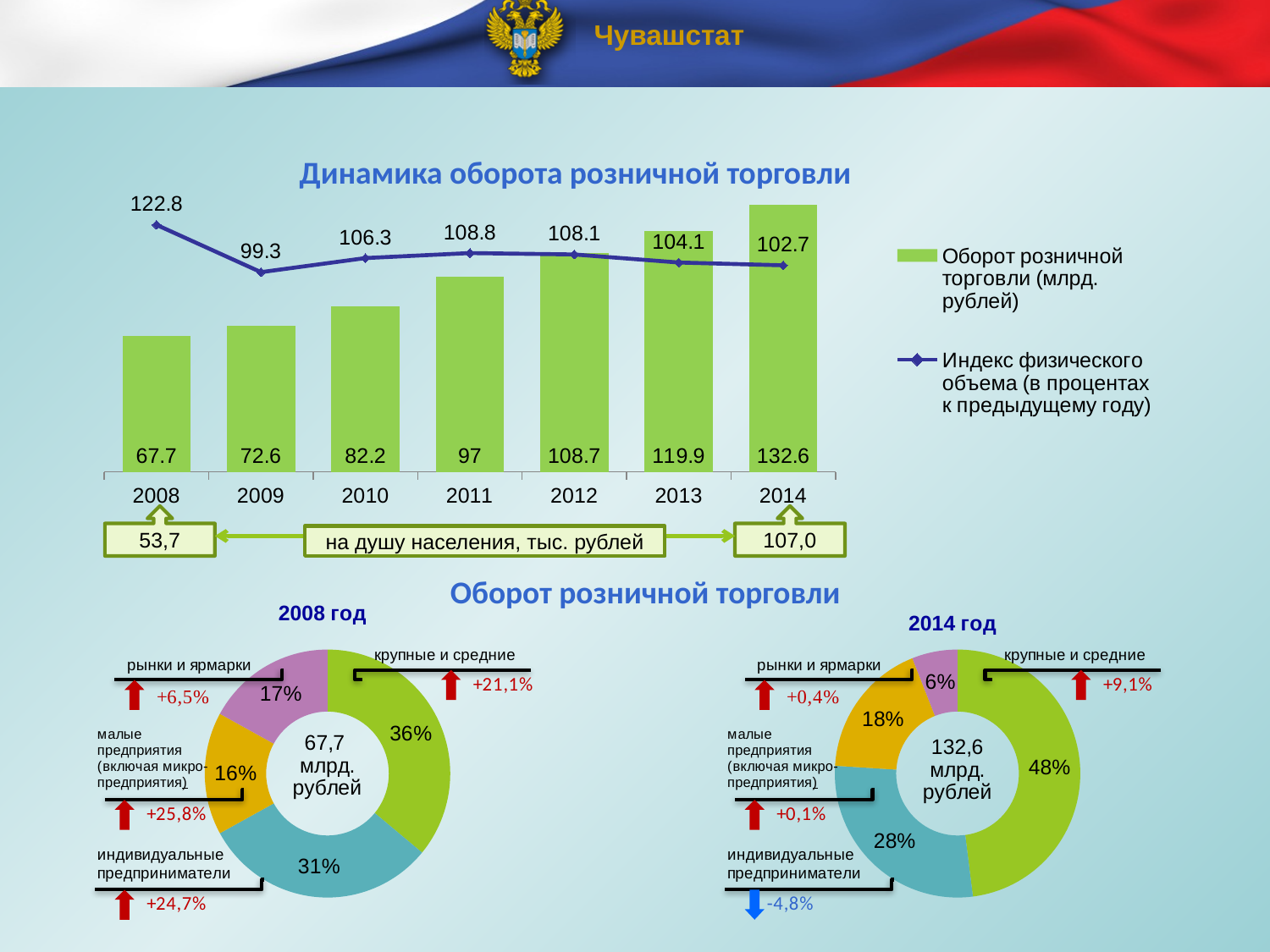
In the chart 'Динамика оборота розничной торговли', do the retail trade turnover bars rise or fall from 2008 to 2014? rise In the chart 'Динамика оборота розничной торговли', how many series does the legend list? 2 In the '2008 год' donut chart, what share do 'индивидуальные предприниматели' have? 31% In the chart 'Динамика оборота розничной торговли', what is the difference between the retail trade turnover in 2014 and in 2008? 64.9 In the chart 'Динамика оборота розничной торговли', which year has the lowest value on the 'Индекс физического объема' line? 2009 In the chart 'Динамика оборота розничной торговли', what is the retail trade turnover (млрд. рублей) for 2011? 97 What type of chart is used for the '2008 год' and '2014 год' breakdowns of retail trade turnover? donut (pie) chart In the chart 'Динамика оборота розничной торговли', what is the value of the 'Индекс физического объема' line for 2008? 122.8 In the '2014 год' donut chart, which category has the largest share? крупные и средние In the '2014 год' donut chart, what share do 'рынки и ярмарки' have? 6% In the chart 'Динамика оборота розничной торговли', how many years are shown on the x axis? 7 In the chart 'Динамика оборота розничной торговли', which year has the highest retail trade turnover bar? 2014